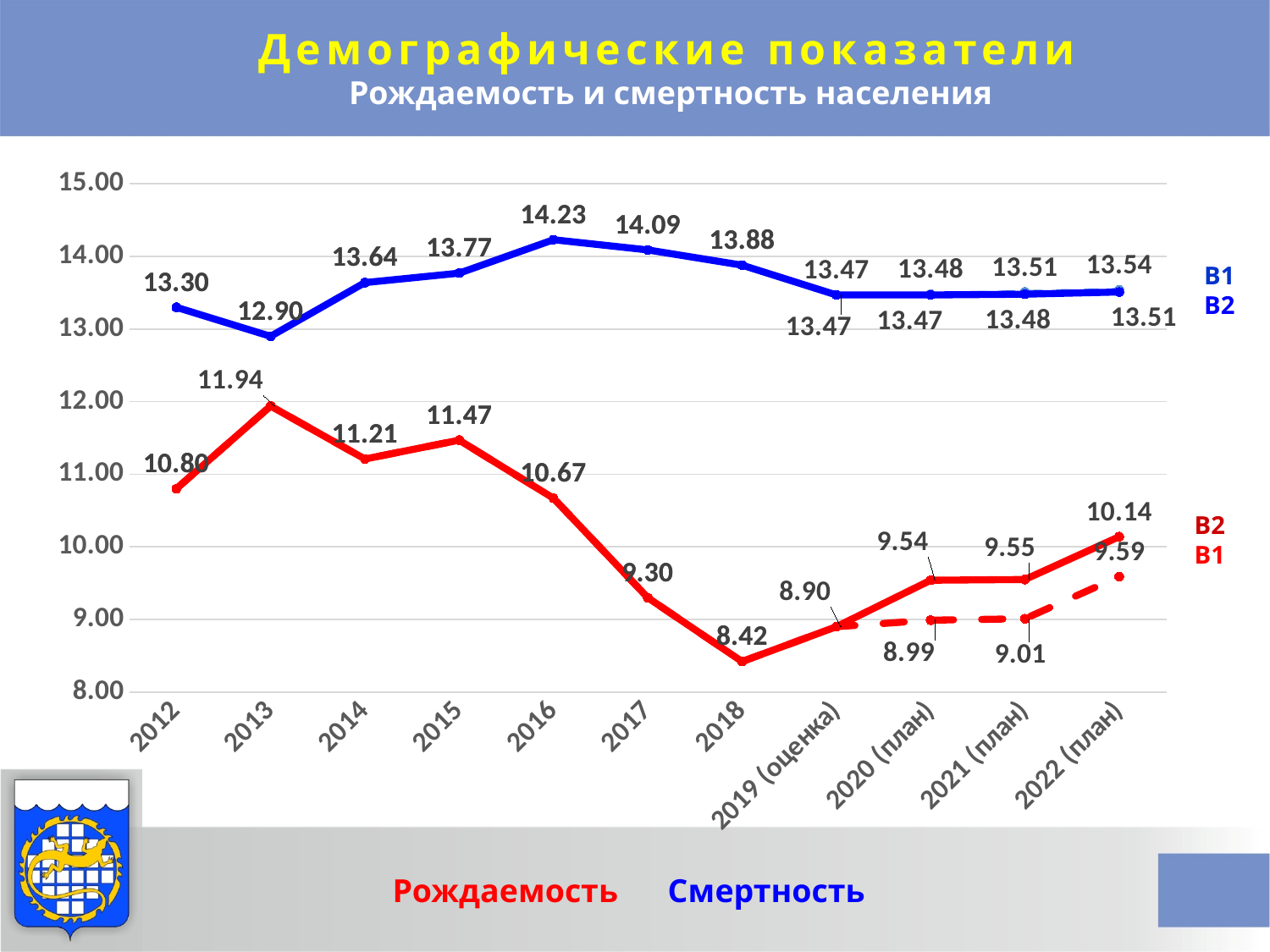
Does Рождаемость rise or fall from 2015 to 2018? fall How many years (categories) are shown on the x axis? 11 In which year does Смертность reach its highest value? 2016 What is the value of Рождаемость for 2022 (план) under scenario В2? 10.14 In which year does Рождаемость reach its lowest value? 2018 Which is larger in 2017: Смертность or Рождаемость? Смертность What is the value of Смертность (blue line) in 2016? 14.23 What kind of chart is shown on the slide? line chart Is the value of Рождаемость in 2016 greater or less than 10.00? greater What is the value of Рождаемость in 2018? 8.42 What is the value of Рождаемость (red line) in 2013? 11.94 What is the difference between Смертность and Рождаемость in 2012? 2.50